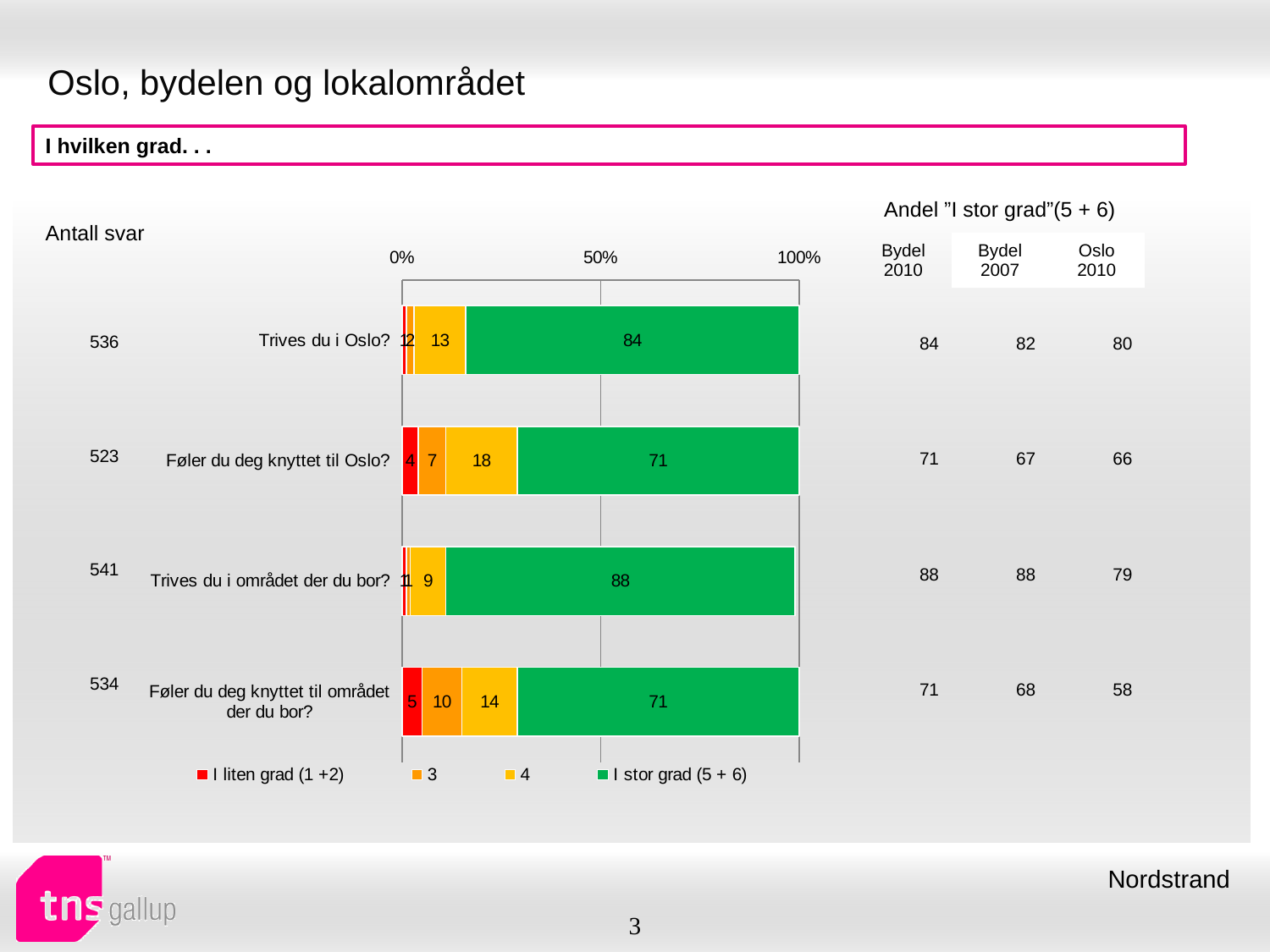
What kind of chart is shown on the slide? bar chart What is the value of series "3" for "Føler du deg knyttet til området der du bor?"? 10 What colour represents "I stor grad (5 + 6)" in the chart? green Which is larger: the "I liten grad (1 +2)" value for "Føler du deg knyttet til Oslo?" or for "Føler du deg knyttet til området der du bor?"? Føler du deg knyttet til området der du bor? What is the value of "I stor grad (5 + 6)" for "Trives du i området der du bor?"? 88 What is the value of series "4" for "Føler du deg knyttet til Oslo?"? 18 Is the "I stor grad (5 + 6)" value for "Føler du deg knyttet til Oslo?" greater or less than 50%? greater How many questions (categories) are plotted in the chart? 4 How many series does the legend list? 4 Which question has the highest "I stor grad (5 + 6)" value? Trives du i området der du bor? What is the value of "I stor grad (5 + 6)" for "Trives du i Oslo?"? 84 What is the difference between the "I stor grad (5 + 6)" values for "Trives du i området der du bor?" and "Trives du i Oslo?"? 4